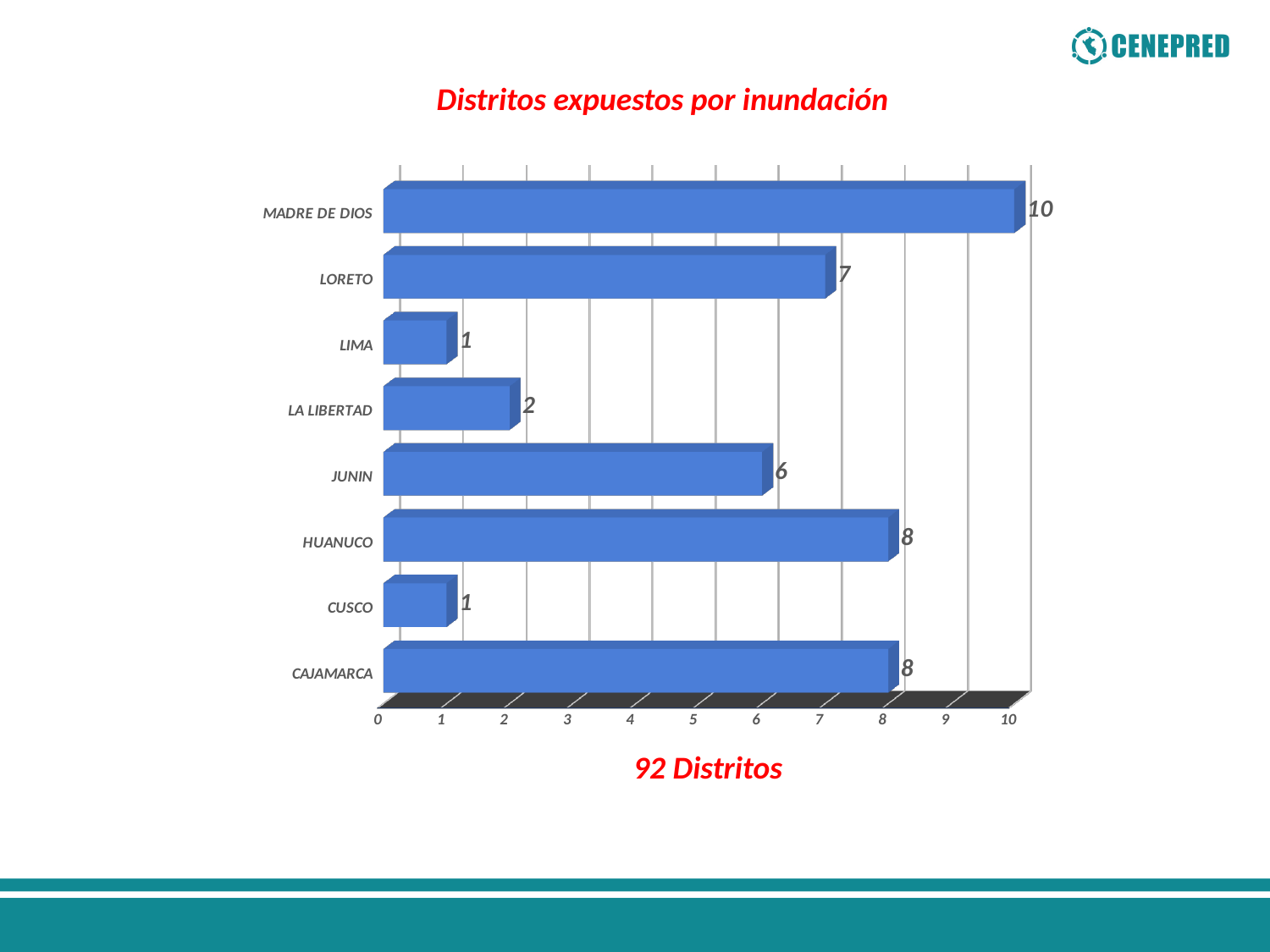
How many regions are shown in the chart? 8 How many districts are shown for MADRE DE DIOS? 10 What type of chart is shown on the slide? Bar chart What is the difference between the values for HUANUCO and JUNIN? 2 What is the title of the chart? Distritos expuestos por inundación What is the value for LORETO? 7 Which region has the highest value in the chart? MADRE DE DIOS Which is larger, the value for LORETO or the value for JUNIN? LORETO What is the value for LA LIBERTAD? 2 What is the difference between the values for MADRE DE DIOS and LORETO? 3 Is the value for HUANUCO greater or less than 5? greater What is the value for JUNIN? 6